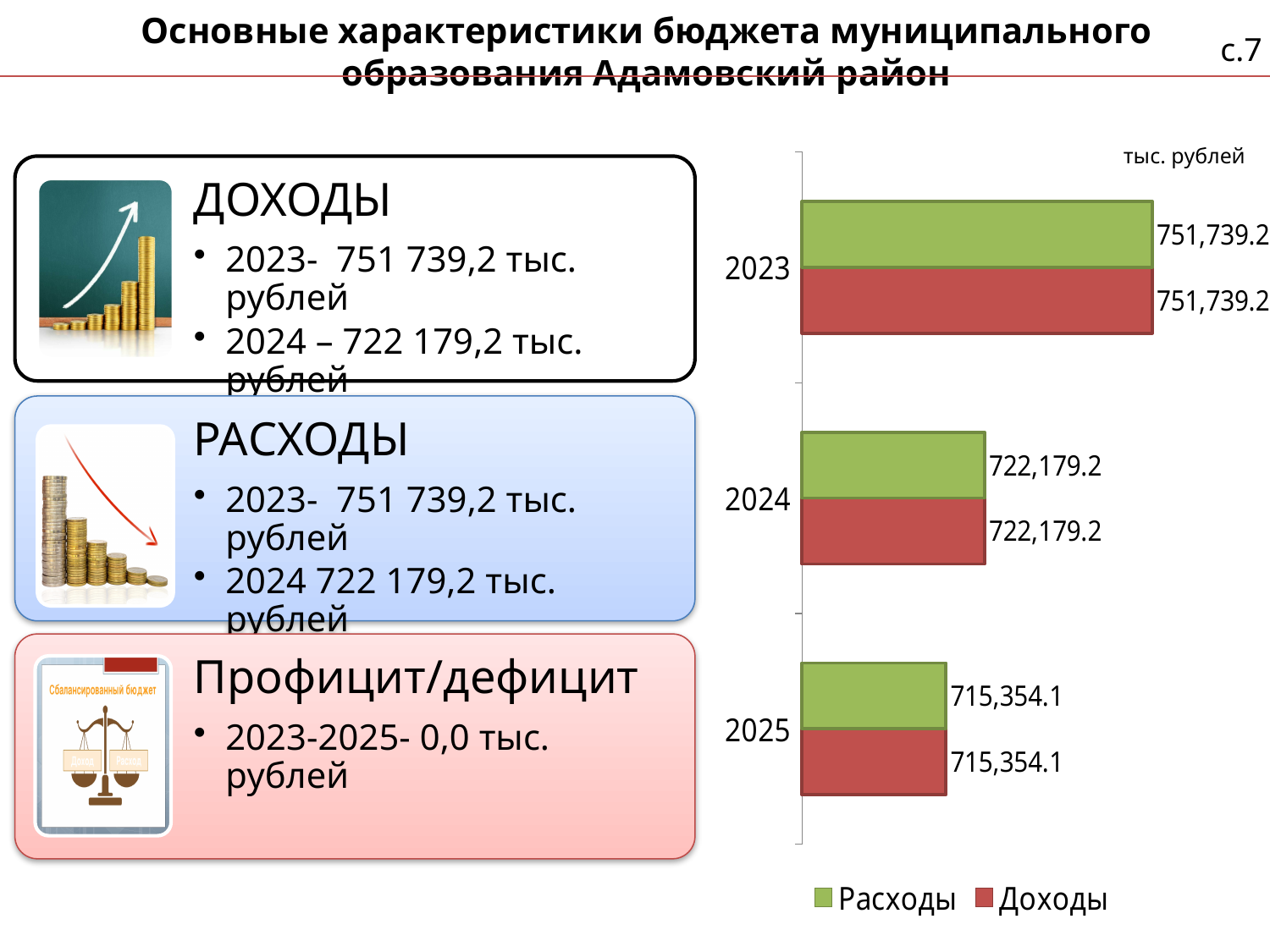
What is the difference between Доходы in 2023 and Доходы in 2024? 29,560.0 Which year has the lowest value of Расходы? 2025 Which is larger: Расходы in 2023 or Расходы in 2025? Расходы in 2023 What is the value of Расходы for 2023? 751,739.2 What is the value of Расходы for 2025? 715,354.1 How many series does the legend list? 2 Which year has the highest value of Доходы? 2023 How many years are shown on the chart? 3 What is the difference between Расходы in 2024 and Расходы in 2025? 6,825.1 What kind of chart is shown on the slide? bar chart Do the values of Доходы rise or fall from 2023 to 2025? fall What is the value of Доходы for 2024? 722,179.2